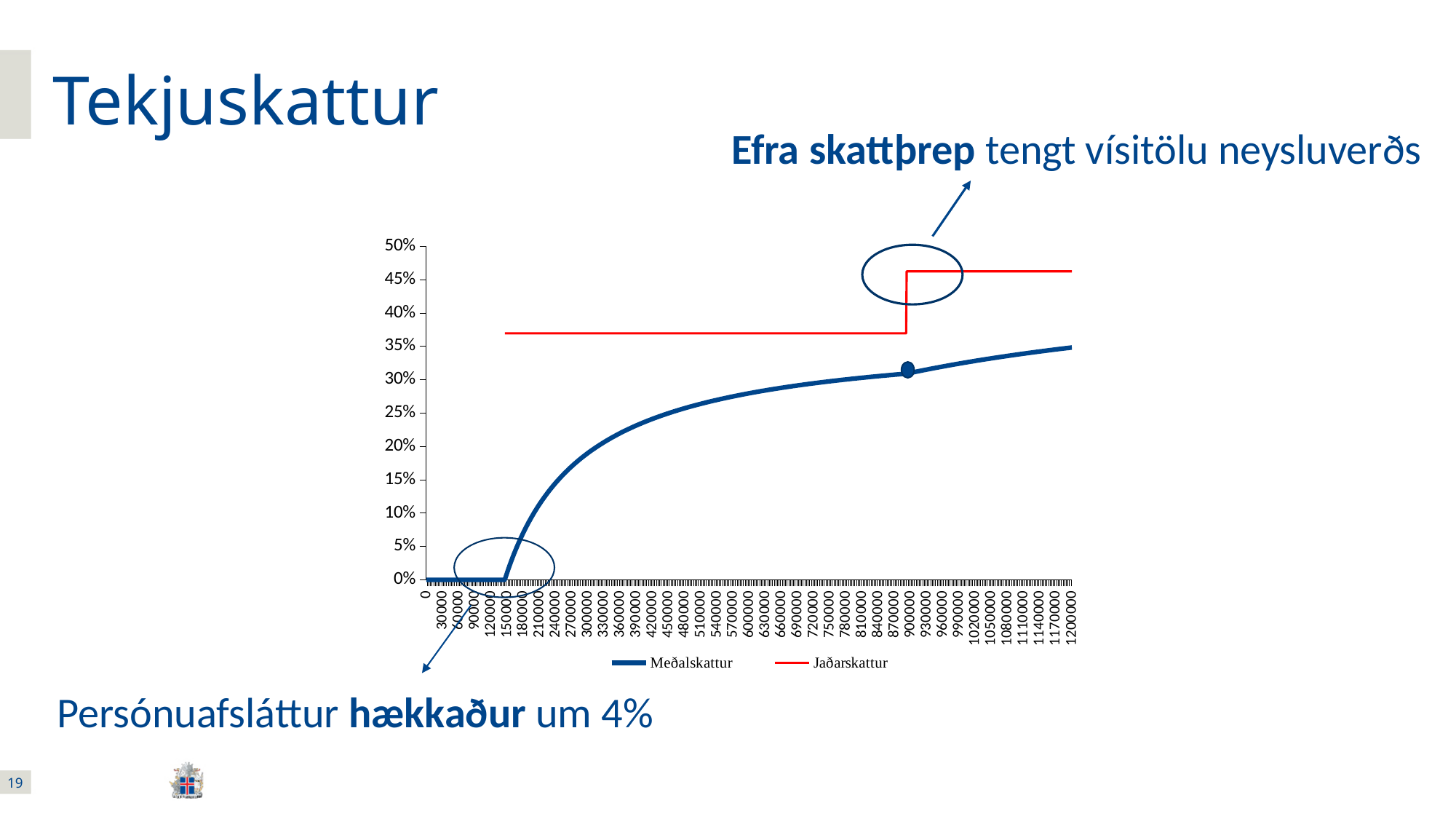
What kind of chart is shown on the slide? line chart Does the Meðalskattur line rise or fall as the x axis values increase beyond 150000? rise Which colour is used for the Jaðarskattur line? red Is the value of Jaðarskattur at 1200000 greater or less than 45%? greater What is the value of Meðalskattur at an x value of 0? 0% Is the value of Jaðarskattur at 300000 greater or less than 40%? less Is the value of Meðalskattur at 600000 greater or less than 25%? greater At an x value of 600000, which series has the higher value, Meðalskattur or Jaðarskattur? Jaðarskattur How many series does the chart legend list? 2 What are the two series named in the chart legend? Meðalskattur and Jaðarskattur